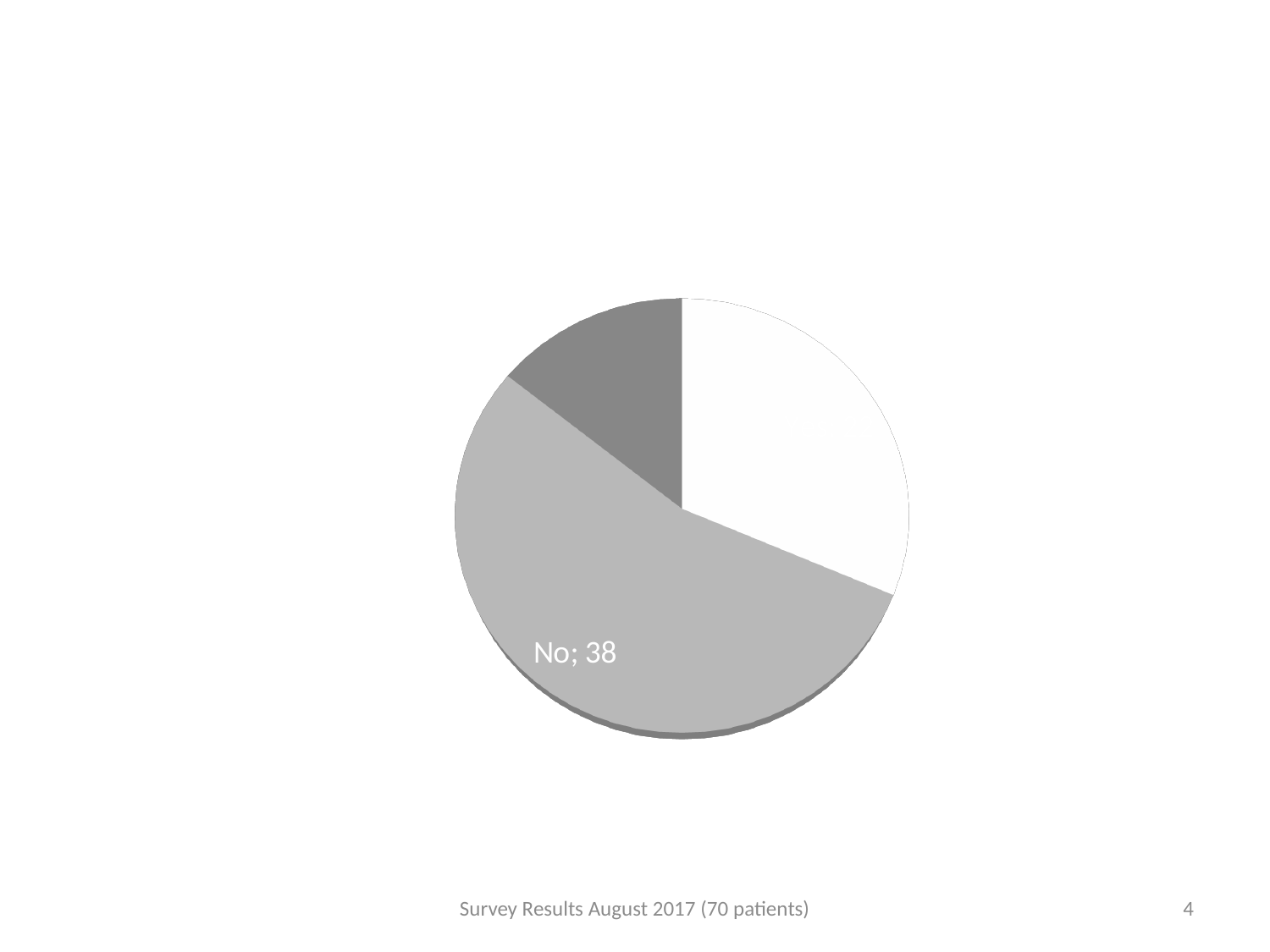
What kind of chart is shown on the slide? pie chart Which slice of the pie chart is the largest? No What colour is the "No" slice of the pie chart? grey What is the value shown for the "No" slice of the pie chart? 38 Which slice of the pie chart has a data label printed on it? No How many slices does the pie chart have? 3